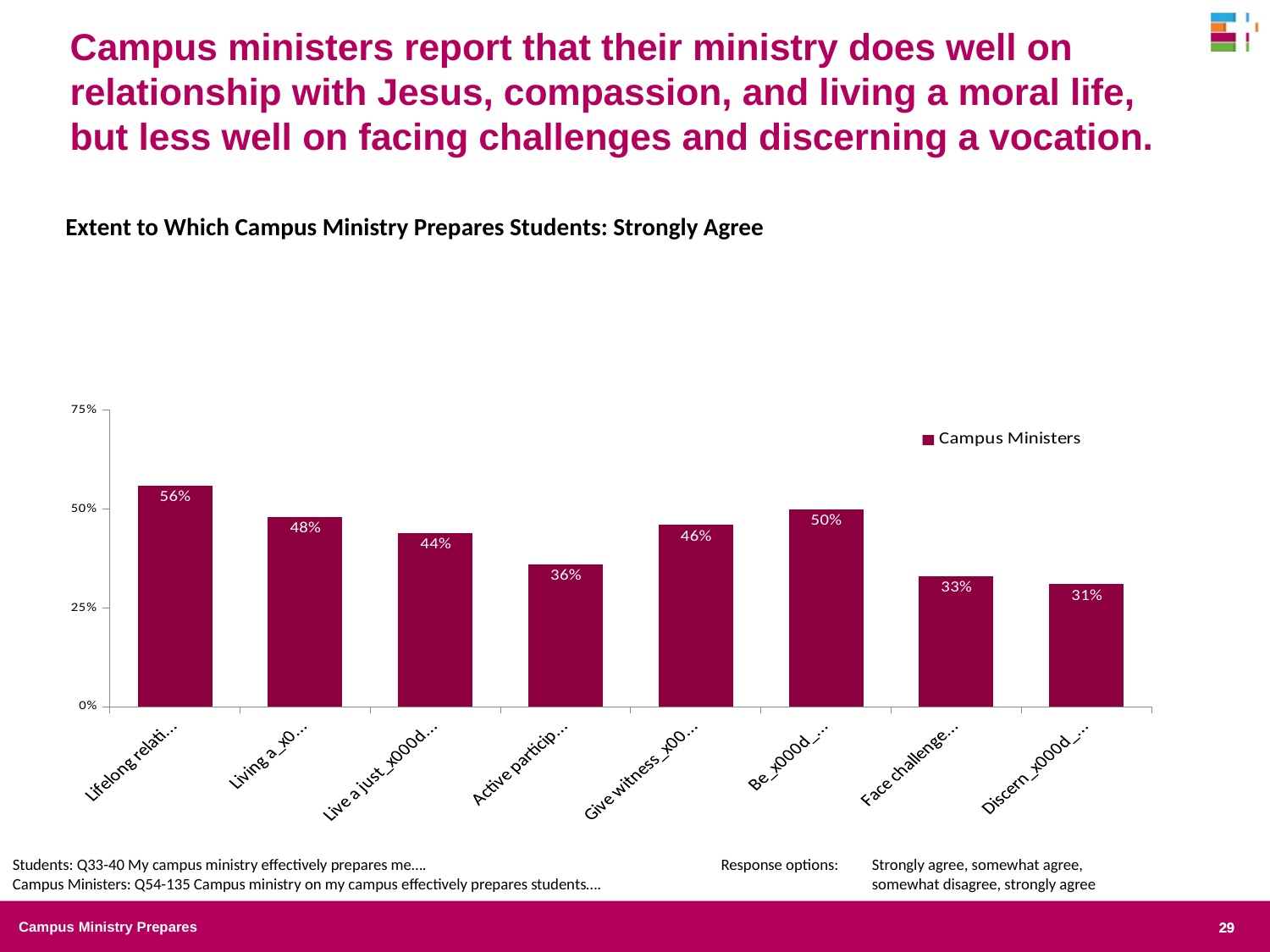
Is the value for the bar labelled 'Face challenge...' greater or less than 25%? greater Which is larger: the sixth bar (labelled 'Be...') or the fifth bar (labelled 'Give witness...')? The sixth bar (Be...), 50% What is the value of the first bar (the one labelled 'Lifelong relati...')? 56% What series name is shown in the chart legend? Campus Ministers What is the value of the bar labelled 'Active particip...'? 36% What is the value of the bar labelled 'Face challenge...'? 33% What kind of chart is shown on the slide? bar chart How many series does the legend list? 1 Which bar has the highest value? The first bar (Lifelong relati...), 56% How many bars are plotted in the chart? 8 Which bar has the lowest value? The last bar (Discern...), 31% What is the difference between the first bar (56%) and the last bar (31%)? 25 percentage points